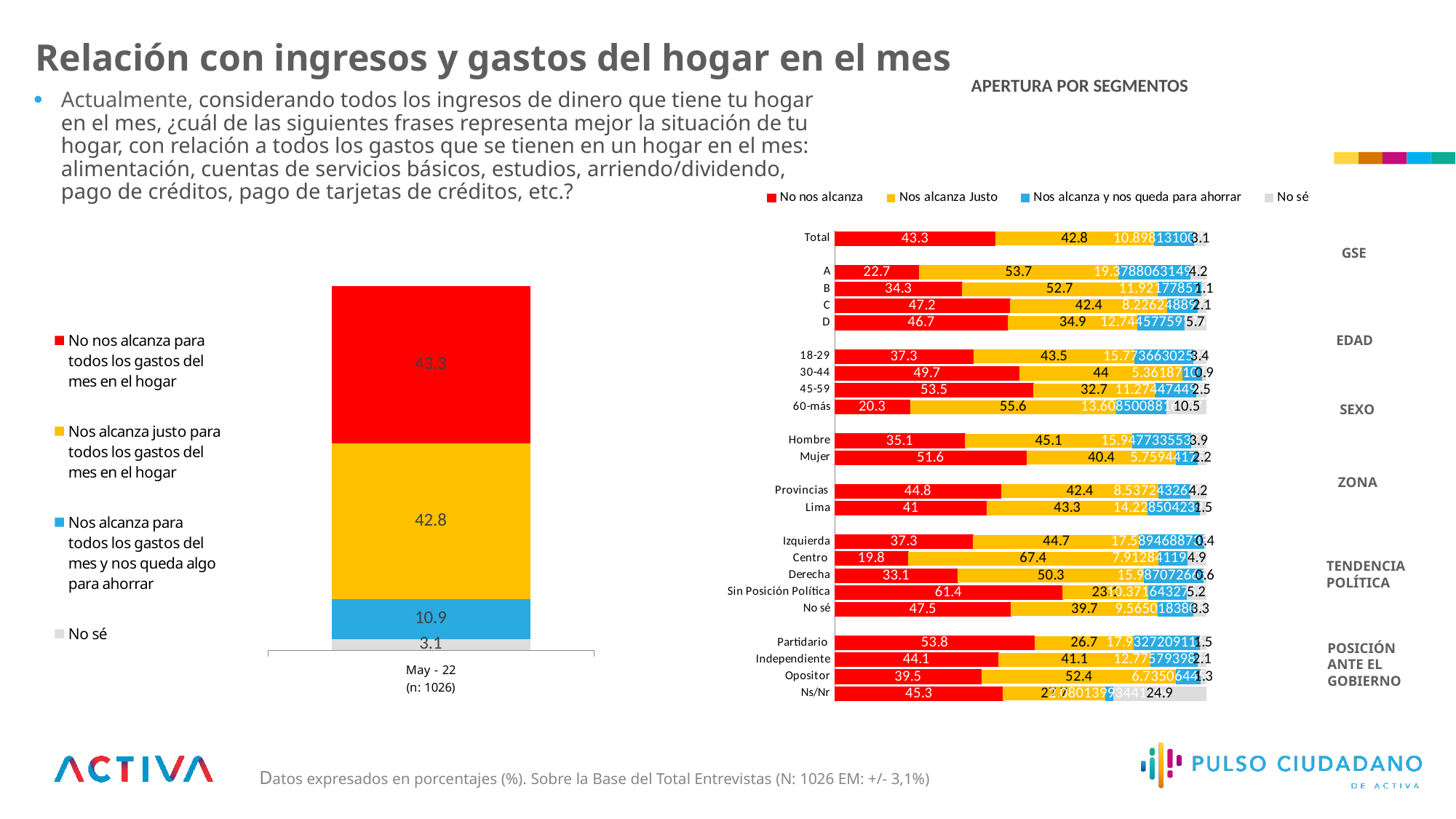
What kind of chart is the left chart? Stacked bar chart On the right chart (Apertura por segmentos), which age group (EDAD) has the highest 'No nos alcanza' value? 45-59 On the right chart (Apertura por segmentos), which GSE segment has the lowest 'No nos alcanza' value? A On the left chart, what is the value for 'No sé'? 3.1 On the right chart (Apertura por segmentos), which has a larger 'No nos alcanza' value, Hombre or Mujer? Mujer On the left chart, what is the difference between 'Nos alcanza justo' (42.8) and 'Nos alcanza y nos queda algo para ahorrar' (10.9)? 31.9 On the right chart (Apertura por segmentos), what is the 'Nos alcanza Justo' value for 'Centro'? 67.4 On the right chart (Apertura por segmentos), what is the difference in 'No nos alcanza' between Provincias (44.8) and Lima (41)? 3.8 On the left chart, how many entries does the legend list? 4 On the right chart (Apertura por segmentos), what is the 'No nos alcanza' value for 'Sin Posición Política'? 61.4 On the left chart, what is the value for 'No nos alcanza para todos los gastos del mes en el hogar'? 43.3 On the right chart (Apertura por segmentos), what is the 'No sé' value for 'Ns/Nr'? 24.9